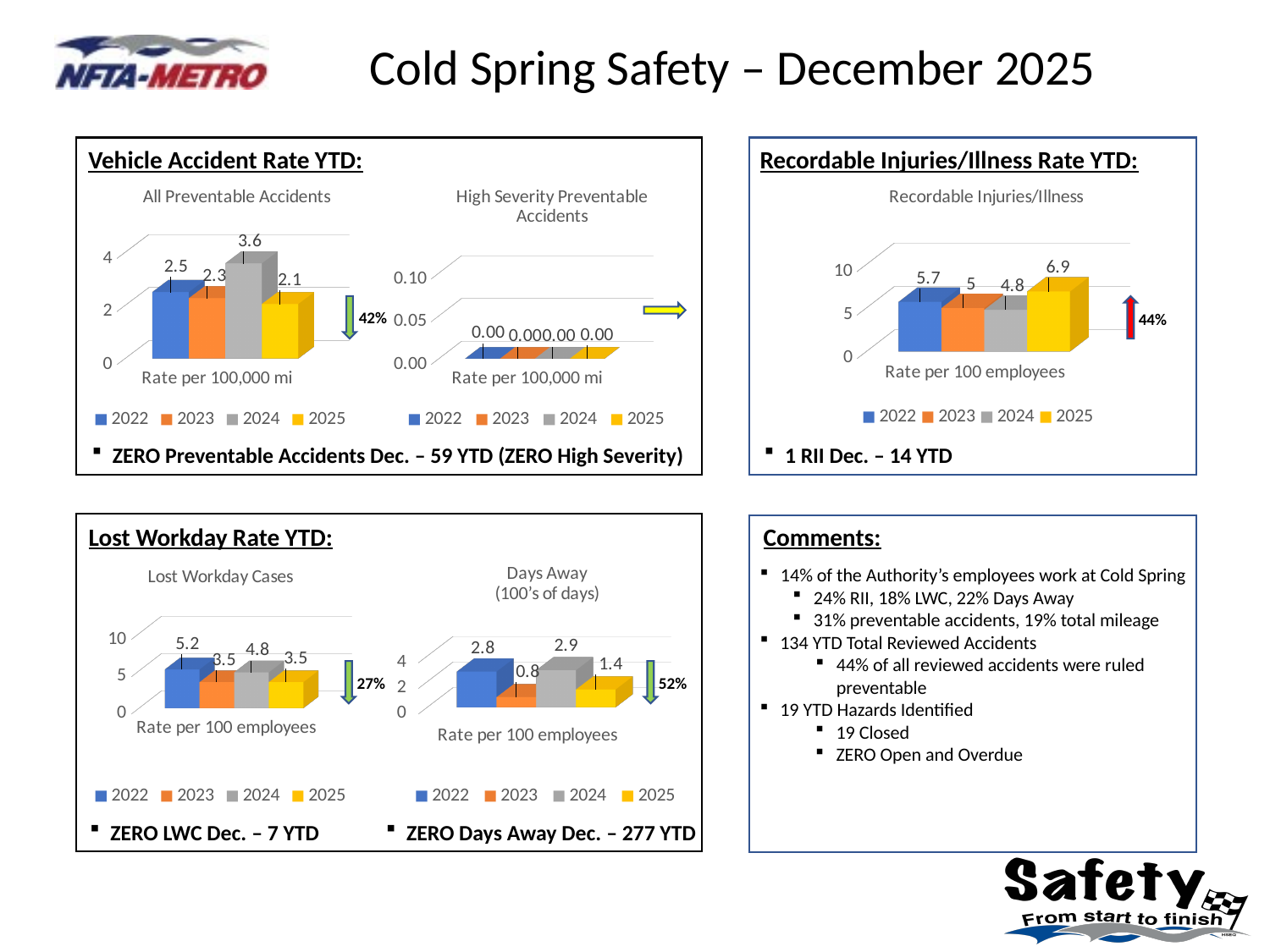
In the Days Away chart, which year has the lowest value? 2023 In the Recordable Injuries/Illness chart, is the value for 2025 greater or less than 5? greater In the All Preventable Accidents chart, what is the difference between the 2024 and 2025 values? 1.5 In the Lost Workday Cases chart, which is larger, the value for 2022 or the value for 2024? 2022 In the Days Away chart, what is the difference between the 2024 and 2025 values? 1.5 In the High Severity Preventable Accidents chart, what is the value for 2025? 0.00 How many series does the legend of the Days Away chart list? 4 In the Recordable Injuries/Illness chart, which year has the highest value? 2025 In the All Preventable Accidents chart, which year has the lowest value? 2025 In the Recordable Injuries/Illness chart, what is the value for 2023? 5 In the All Preventable Accidents chart, what is the value for 2024? 3.6 In the Lost Workday Cases chart, what is the value for 2022? 5.2